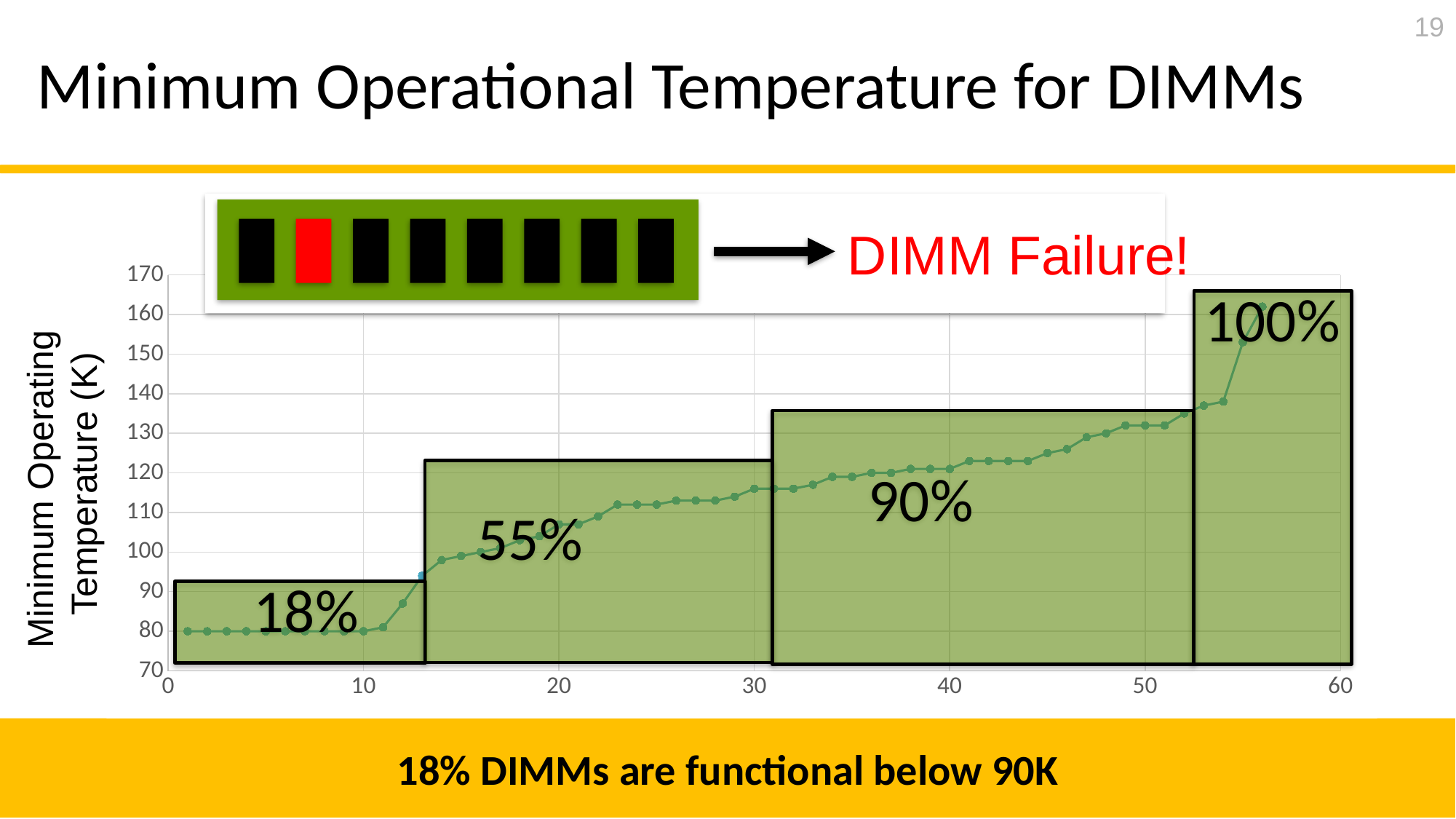
How many highlighted percentage boxes are drawn over the chart? 4 Is the plotted value at x = 5 greater or less than 90? less What percentage label is shown in the leftmost highlighted box? 18% Is the plotted value at x = 56 greater or less than 150? greater What percentage label is shown in the rightmost highlighted box? 100% What kind of chart is shown on the slide? line chart What is the label of the y axis? Minimum Operating Temperature (K) Do the plotted values rise or fall as you move from left to right along the x axis? rise Which is larger, the plotted value at x = 10 or the plotted value at x = 50? x = 50 Is the plotted value at x = 20 greater or less than 100? greater